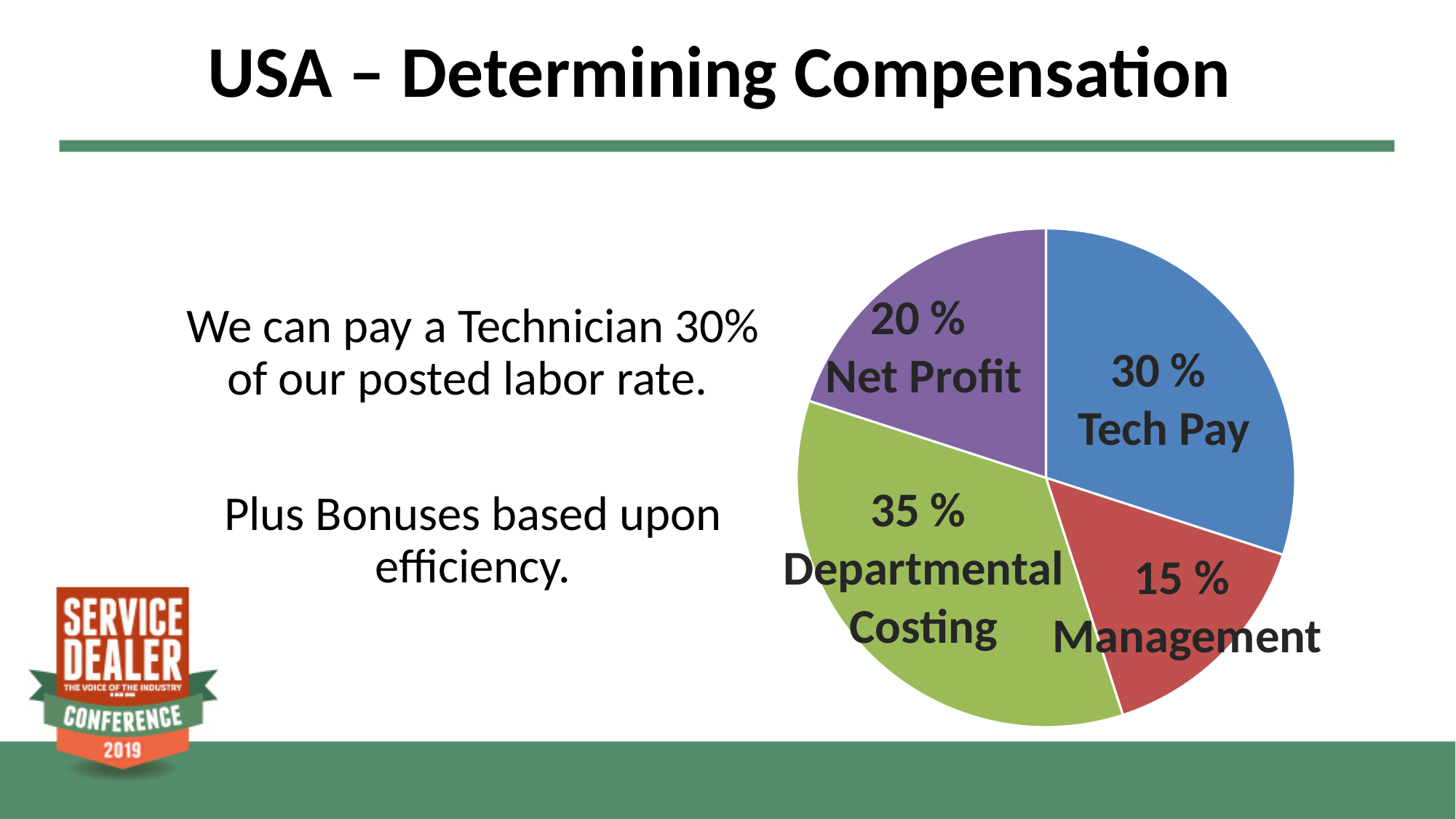
What is the combined share of Tech Pay and Management? 45 % What kind of chart is shown on the slide? pie chart What share of the pie is Management? 15 % Which slice of the pie is the smallest? Management What share of the pie is Tech Pay? 30 % How many slices does the pie chart have? 4 Which is larger, the Tech Pay share or the Net Profit share? Tech Pay What share of the pie is Departmental Costing? 35 % What is the difference between the Departmental Costing share and the Management share? 20 % What colour is the Net Profit slice? purple Which slice of the pie is the largest? Departmental Costing